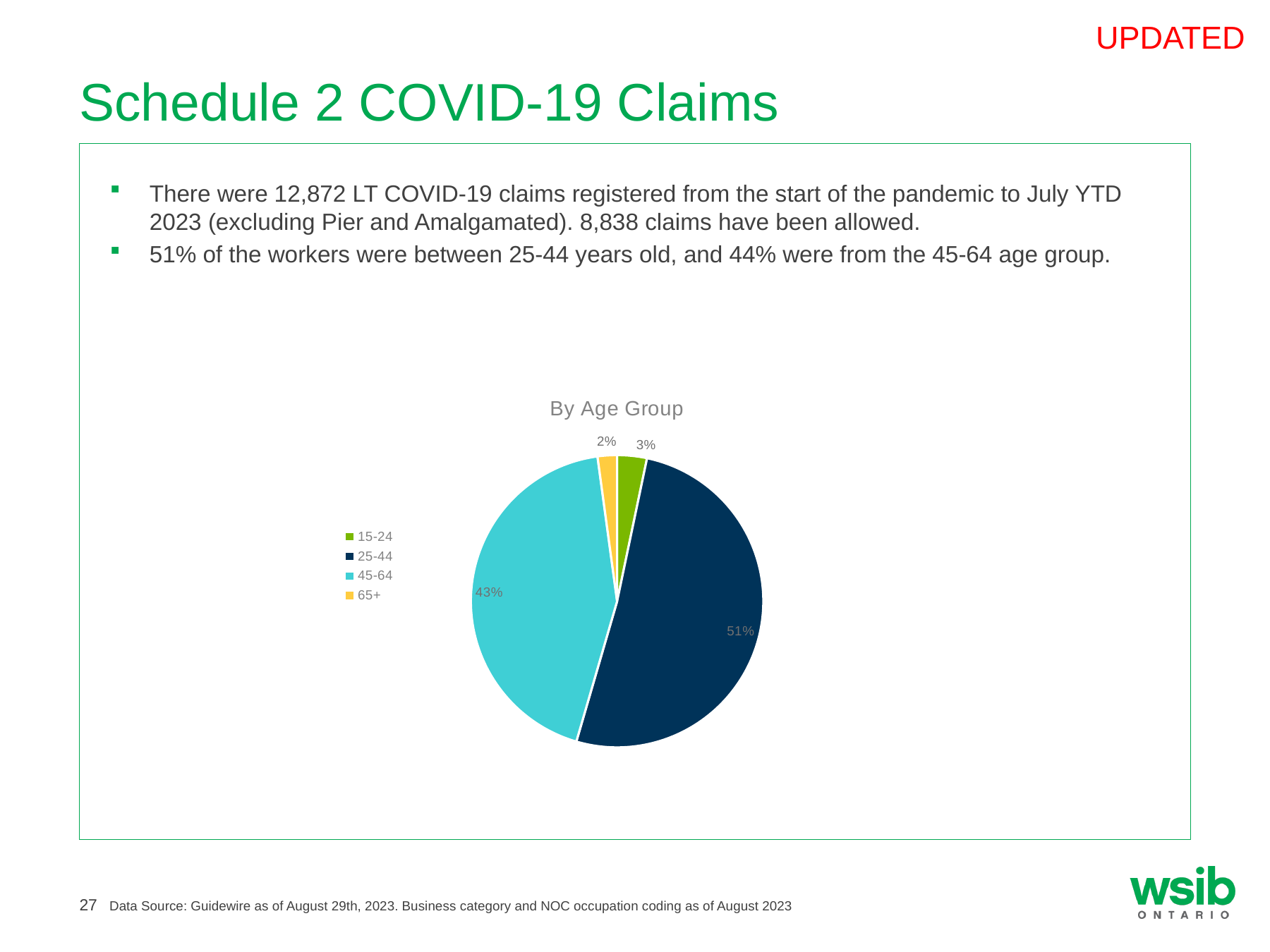
What is the difference in percentage points between the 25-44 and 45-64 age groups? 8 Which colour represents the 45-64 age group in the legend? light blue (cyan) Which age group has the largest share of the pie? 25-44 What share of the pie does the 45-64 age group represent? 43% Which age group has the smallest share of the pie? 65+ What share of the pie does the 25-44 age group represent? 51% What share of the pie does the 15-24 age group represent? 3% How many age groups are shown in the pie chart? 4 What type of chart is shown on the slide? pie chart What share of the pie does the 65+ age group represent? 2% What is the title of the chart? By Age Group Which has a larger share, the 15-24 age group or the 65+ age group? 15-24